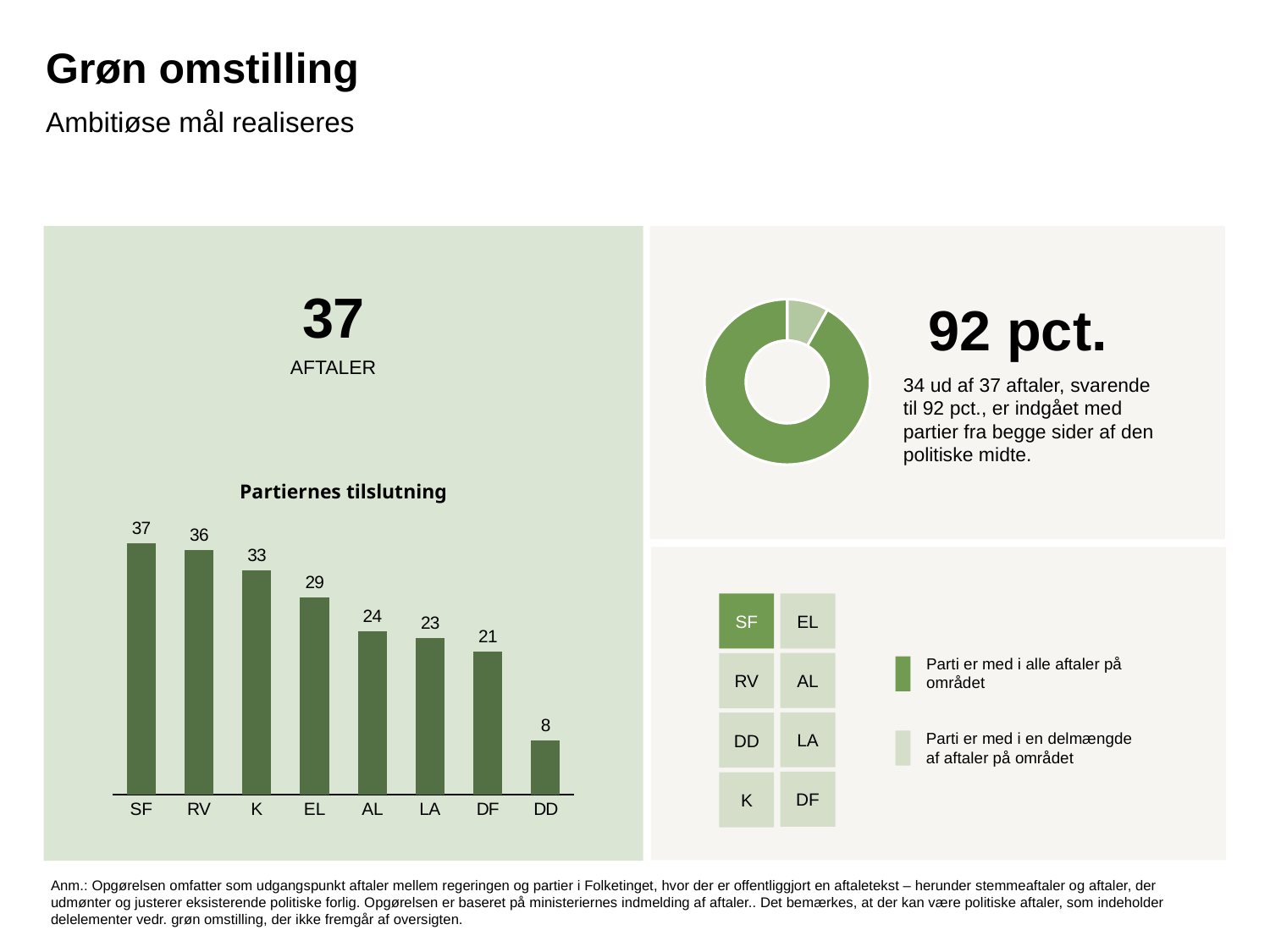
In the 'Partiernes tilslutning' chart, what is the value for DD? 8 In the 'Partiernes tilslutning' chart, which is larger, the value for AL or the value for LA? AL How many parties are shown in the 'Partiernes tilslutning' chart? 8 In the 'Partiernes tilslutning' chart, what is the value for SF? 37 In the 'Partiernes tilslutning' chart, what is the difference between the values for K and DF? 12 What kind of chart is shown next to the '92 pct.' text on the right of the slide? Donut chart In the 'Partiernes tilslutning' chart, what is the value for EL? 29 In the 'Partiernes tilslutning' chart, which party has the lowest value? DD In the 'Partiernes tilslutning' chart, do the values rise or fall from left to right? Fall In the 'Partiernes tilslutning' chart, which party has the highest value? SF What kind of chart is 'Partiernes tilslutning'? Bar chart According to the donut chart on the right, what share of the 37 agreements were made with parties from both sides of the political centre? 92 pct.